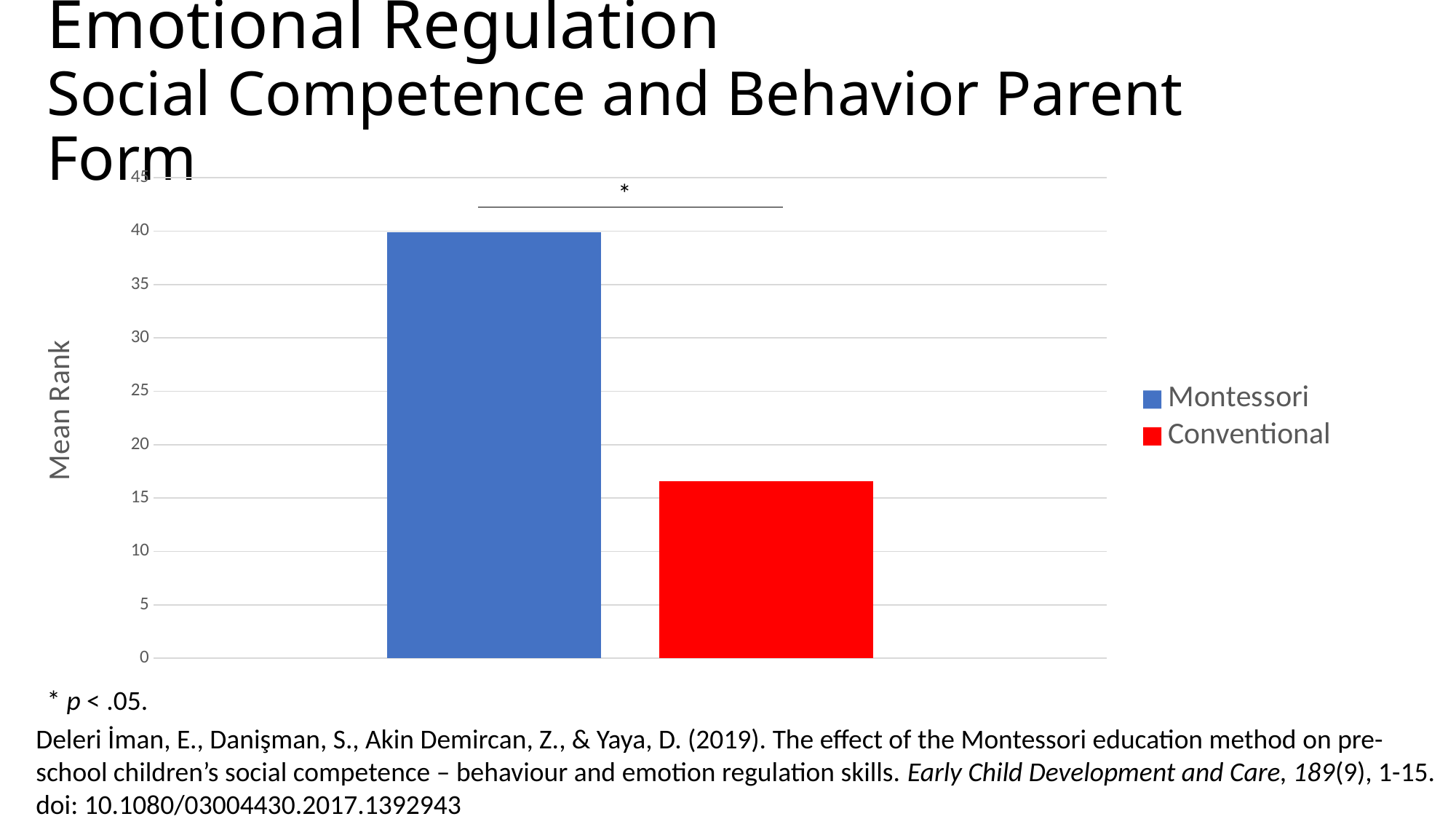
Is the mean rank for Montessori greater or less than 35? greater What colour is the Conventional bar in the chart? red Is the mean rank for Conventional greater or less than 20? less Which group has the lowest mean rank? Conventional Which is larger, the mean rank for Montessori or for Conventional? Montessori Is the mean rank for Conventional greater or less than 15? greater What kind of chart is shown on the slide? bar chart Which group has the highest mean rank? Montessori How many series does the legend list? 2 What is the label on the vertical axis of the chart? Mean Rank How many bars are plotted in the chart? 2